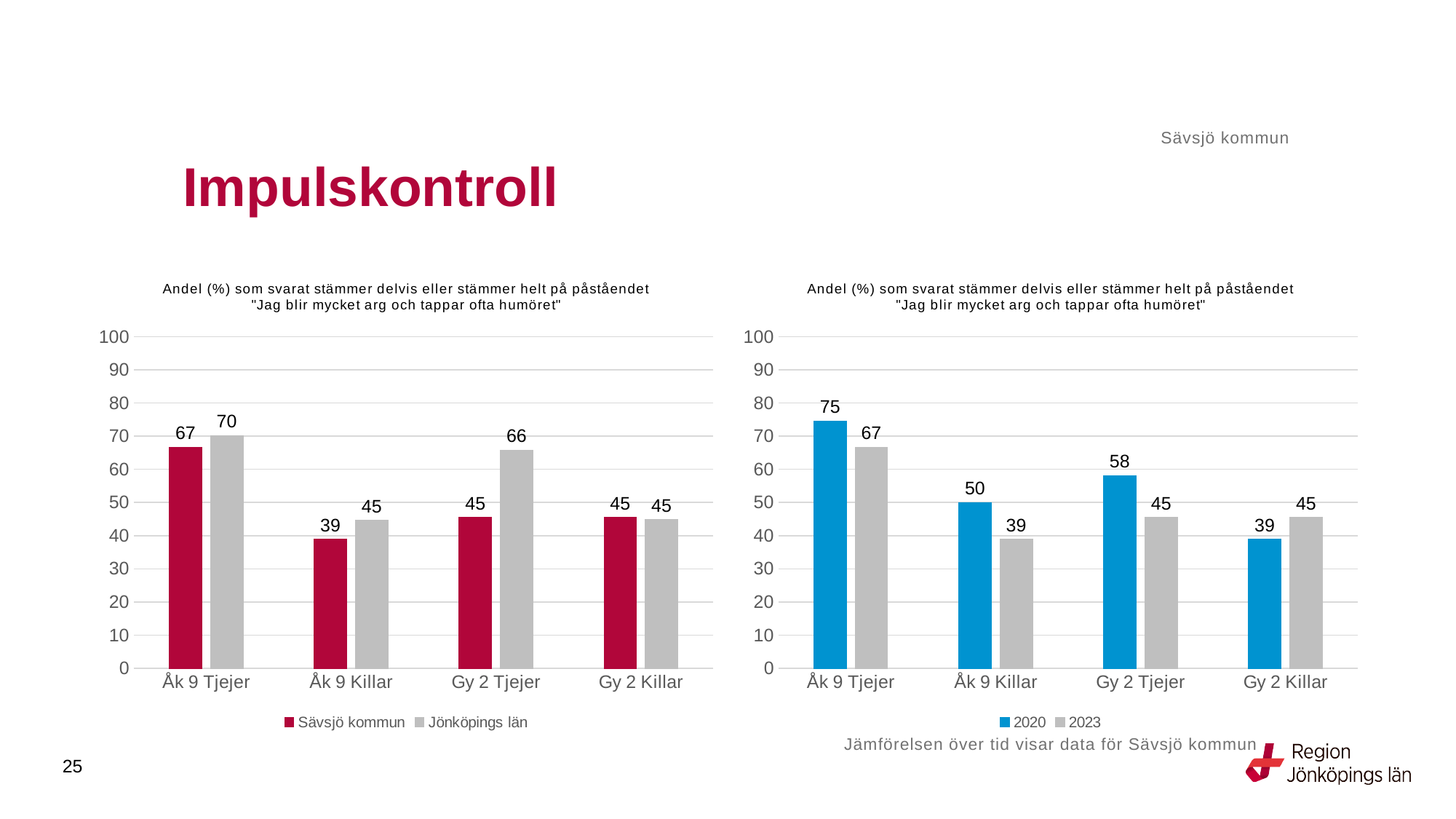
In the right chart, which category has the highest value for 2020? Åk 9 Tjejer In the left chart, which category has the lowest value for Sävsjö kommun? Åk 9 Killar What type of chart is the left chart? Bar chart In the right chart, what is the value for 2020 for Gy 2 Tjejer? 58 In the right chart, what is the value for 2023 for Åk 9 Killar? 39 In the right chart, what is the difference between 2020 and 2023 for Åk 9 Killar? 11 In the right chart, which is larger for Gy 2 Killar: 2020 or 2023? 2023 How many categories are shown on the x axis of the right chart? 4 In the left chart, what is the value for Sävsjö kommun for Åk 9 Tjejer? 67 In the left chart, what is the value for Jönköpings län for Gy 2 Tjejer? 66 In the left chart, how many series does the legend list? 2 In the left chart, what is the difference between Jönköpings län and Sävsjö kommun for Gy 2 Tjejer? 21